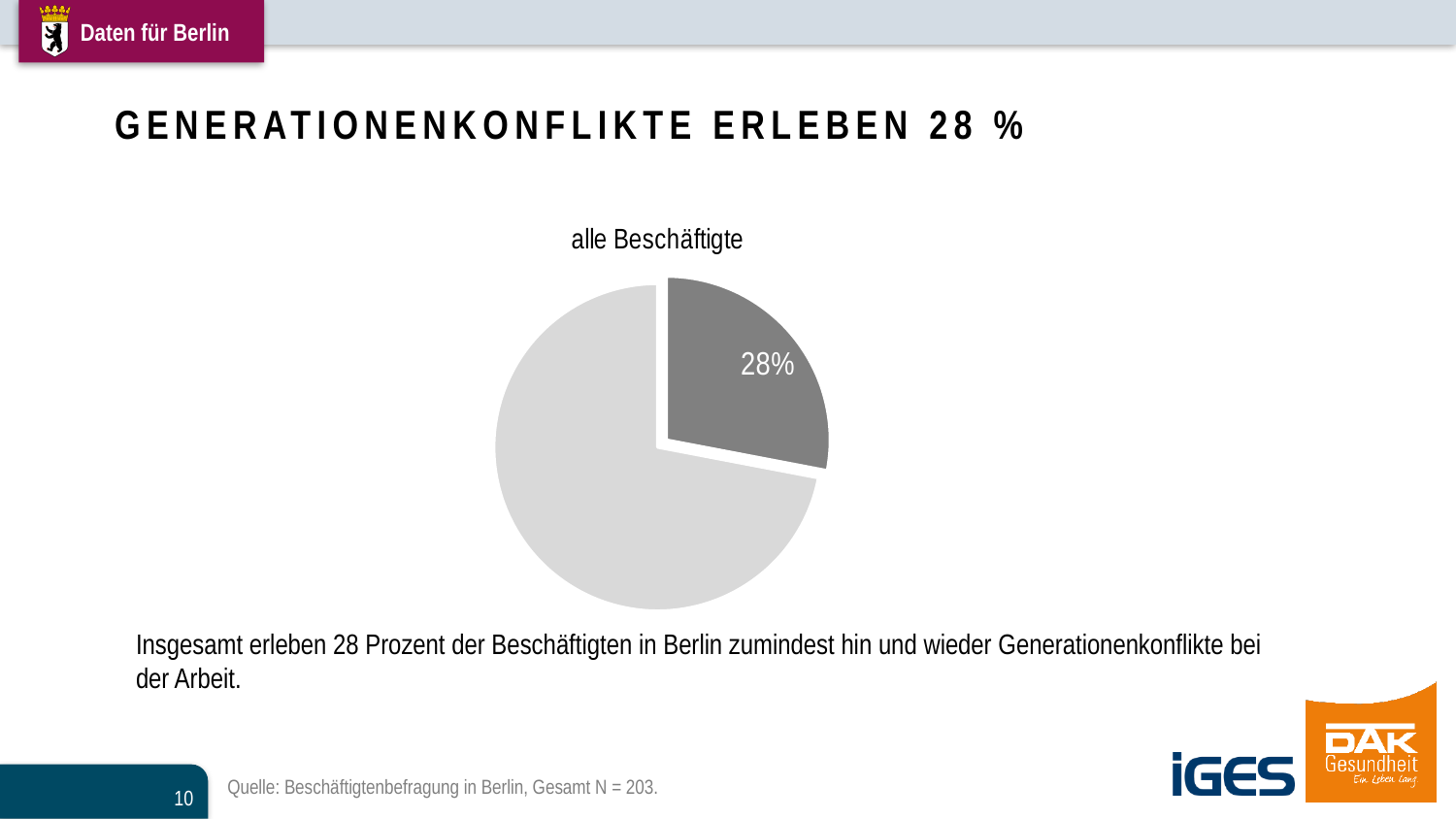
What kind of chart is shown on the slide? pie chart What colour is the slice labelled 28%? dark grey What value is printed on the dark grey slice of the pie chart? 28% What is the title shown above the pie chart? alle Beschäftigte Is the dark grey slice of the pie chart greater or less than half of the pie? less Which slice of the pie chart is larger, the dark grey slice or the light grey slice? the light grey slice What share of the pie does the dark grey slice represent? 28% How many slices does the pie chart have? 2